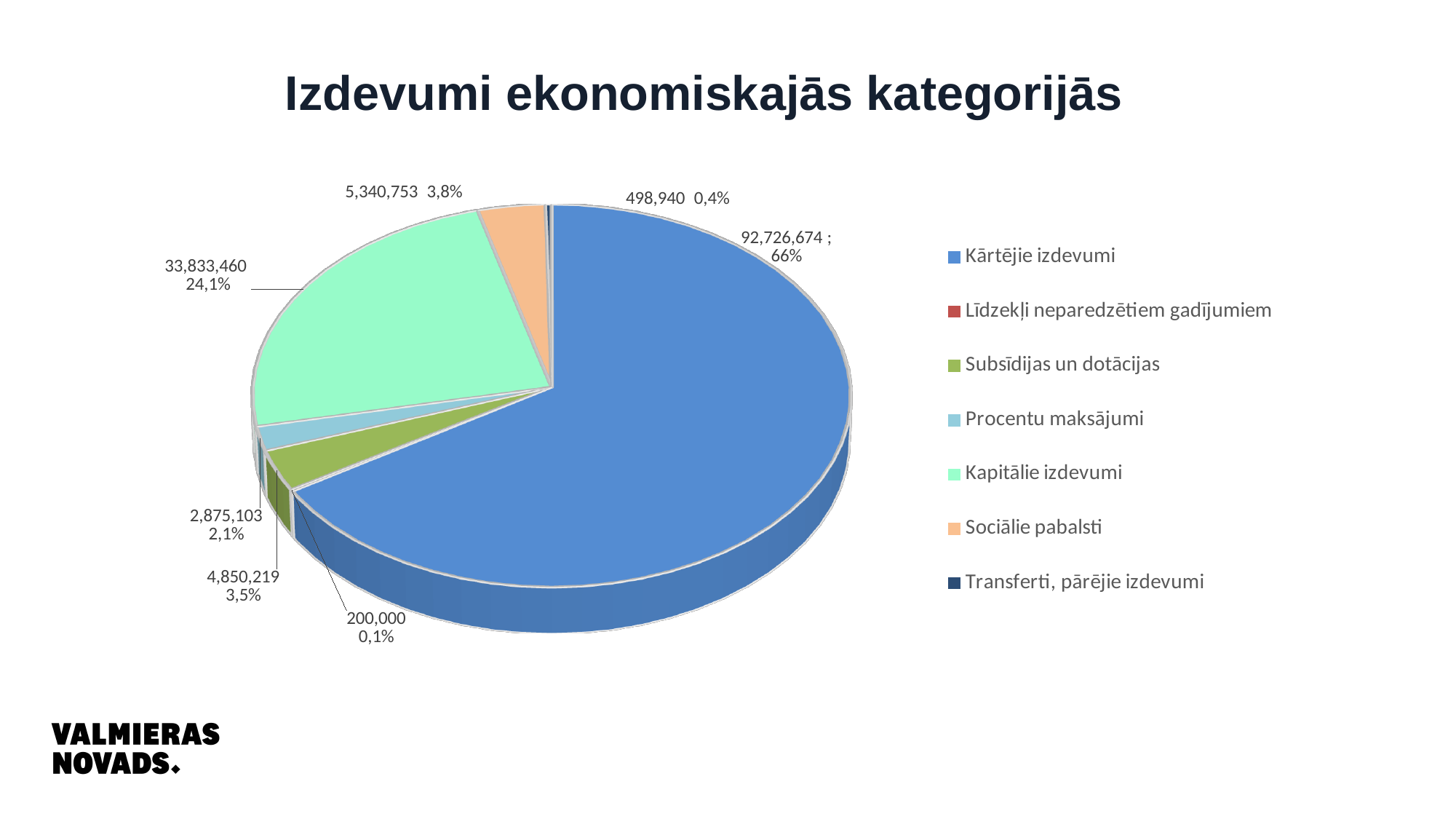
What value is shown for Sociālie pabalsti? 5,340,753 What share of the pie does Subsīdijas un dotācijas represent? 3,5% Which category has the largest slice of the pie? Kārtējie izdevumi Which is larger, the value for Sociālie pabalsti or the value for Procentu maksājumi? Sociālie pabalsti What value is shown for Kapitālie izdevumi? 33,833,460 What share of the pie does Kapitālie izdevumi represent? 24,1% What is the title of the chart? Izdevumi ekonomiskajās kategorijās What share of the pie does Kārtējie izdevumi represent? 66% How many categories does the legend list? 7 What value is shown for Kārtējie izdevumi? 92,726,674 What kind of chart is shown on the slide? pie chart Which category has the smallest slice of the pie? Līdzekļi neparedzētiem gadījumiem